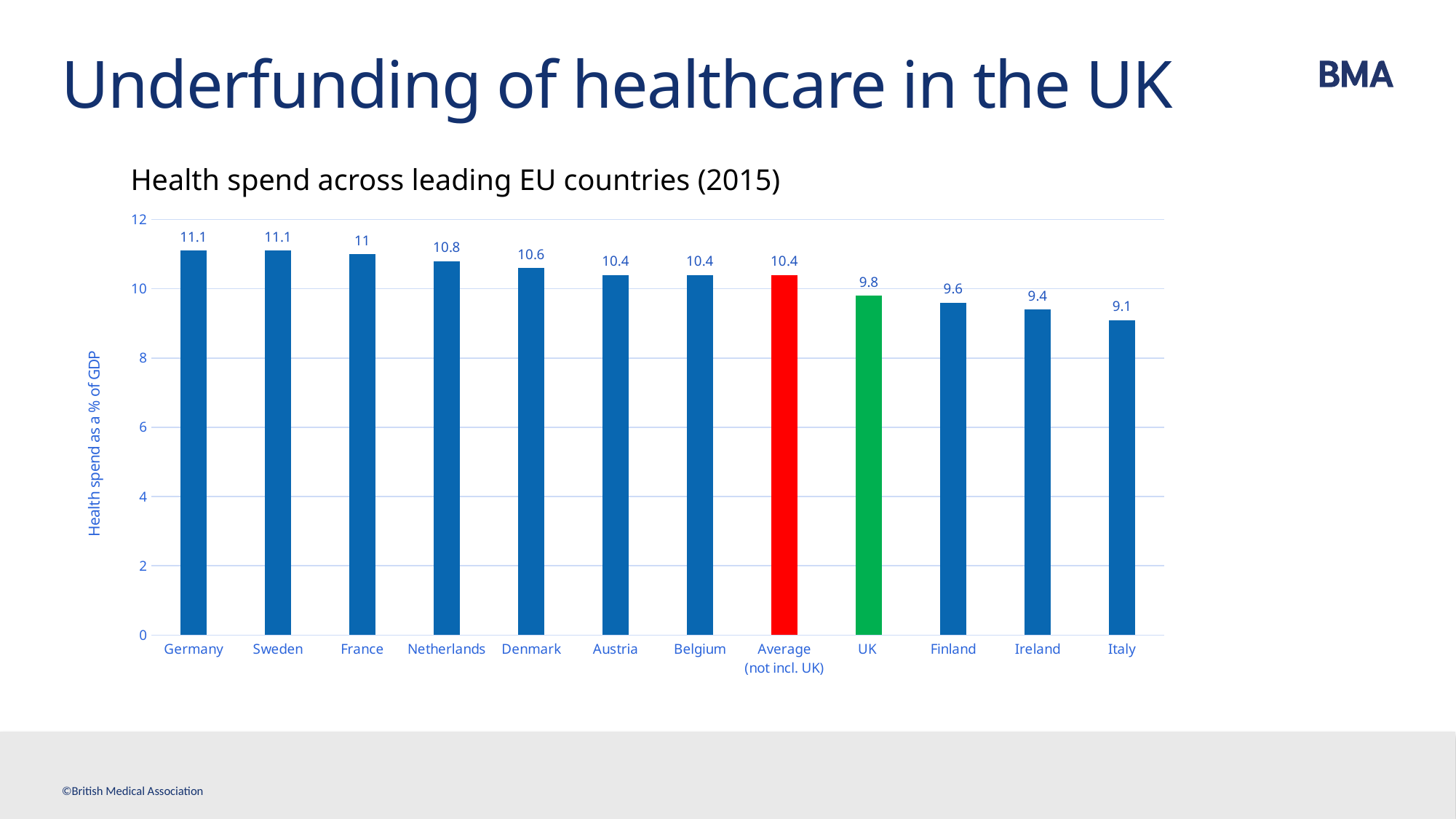
Is the value for Denmark greater or less than 10? greater What is the difference between the Average (not incl. UK) value and the UK value? 0.6 What is the value shown for the Average (not incl. UK) bar? 10.4 What is the value shown for Netherlands? 10.8 Which is larger, the value for Finland or the value for Ireland? Finland Do the values generally rise or fall from left to right along the x axis? Fall What is the health spend as a % of GDP for the UK? 9.8 What colour is the UK bar? Green How many bars are shown in the chart? 12 What is the difference between Germany's value and Italy's value? 2 What kind of chart is shown on the slide? Bar chart Which country has the lowest health spend as a % of GDP? Italy